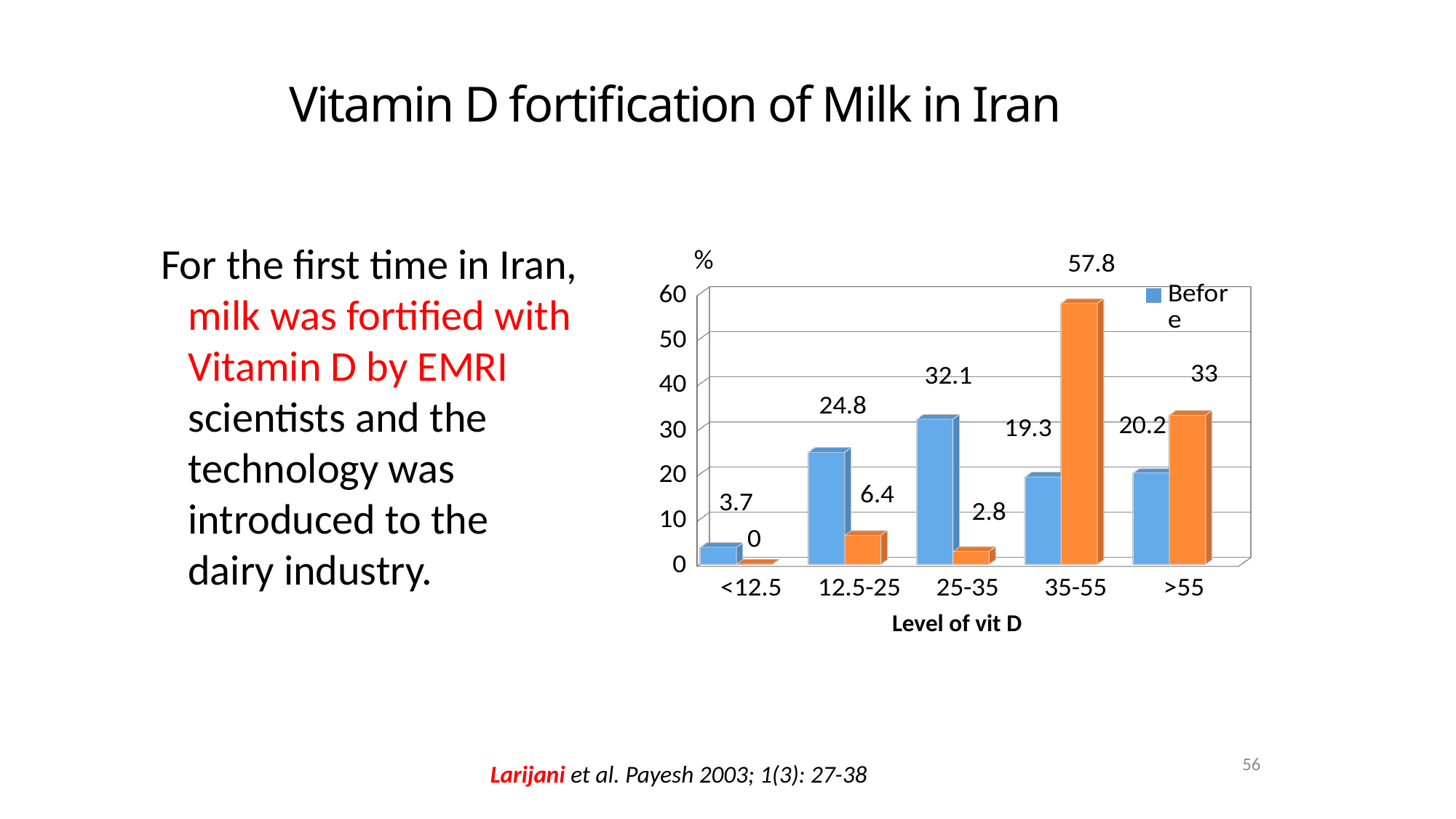
What is the value of the orange series for the 35-55 category? 57.8 What is the difference between the Before values for the 25-35 and 12.5-25 categories? 7.3 For the 35-55 category, how much larger is the orange series value than the Before value? 38.5 Which level of vit D category has the highest Before value? 25-35 For the 12.5-25 category, which is larger: the Before value or the orange series value? Before What is the title of the x axis of the chart? Level of vit D What kind of chart is shown on the slide? Bar chart How many level of vit D categories are shown on the x axis? 5 What is the Before value for the 25-35 level of vit D category? 32.1 What is the value of the orange series for the >55 category? 33 What is the Before value for the <12.5 category? 3.7 Which level of vit D category has the lowest value in the orange series? <12.5